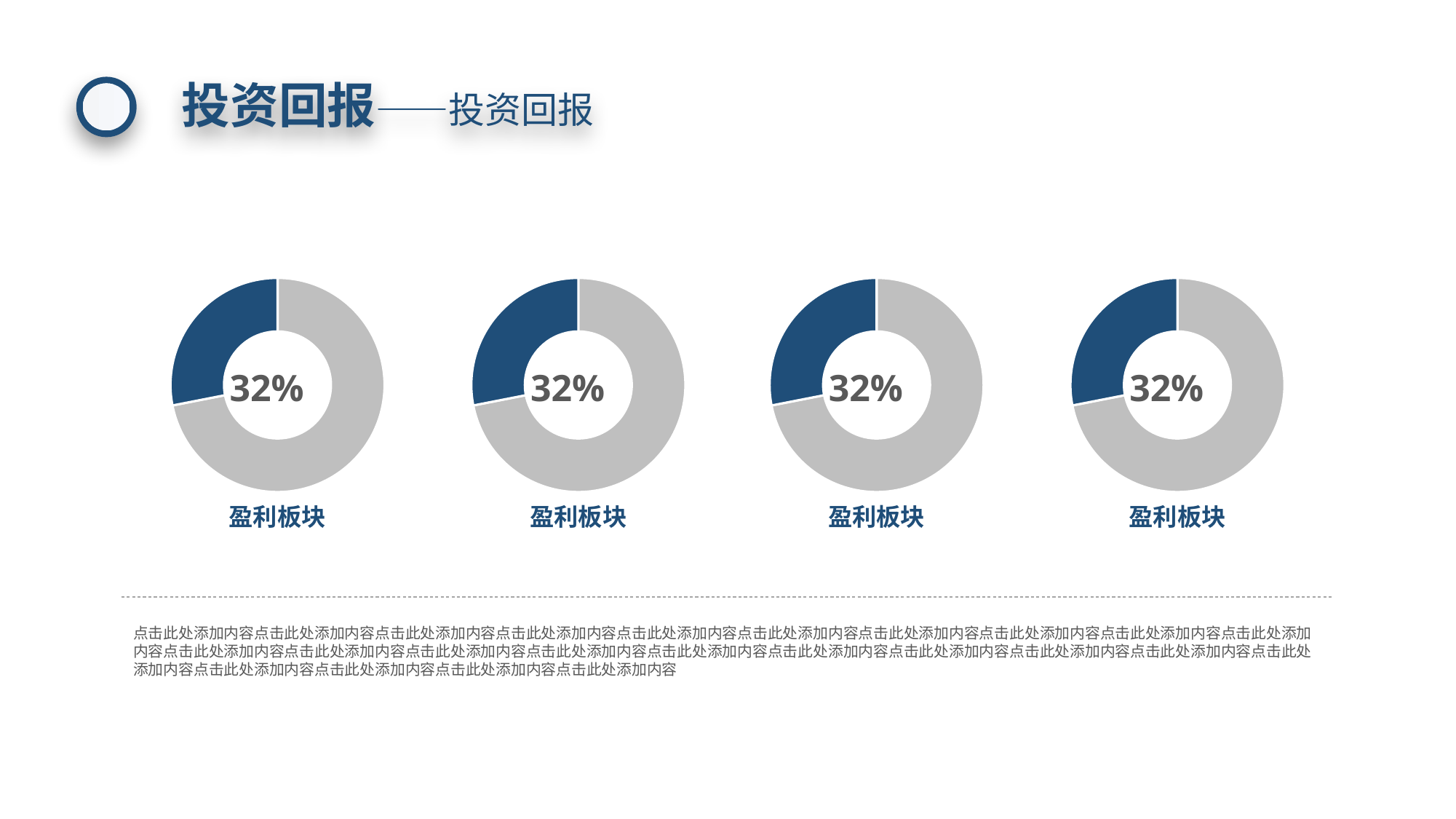
What label appears beneath each of the four donut charts? 盈利板块 In the leftmost donut chart, which colour represents the 32% portion? Blue What percentage is printed in the centre of the rightmost donut chart? 32% What percentage is printed in the centre of the leftmost donut chart? 32% What percentage is printed in the centre of the second donut chart from the left? 32% Is the value shown in the rightmost donut chart greater or less than 50%? less Do the four donut charts all show the same percentage value? Yes How many donut charts are shown on the slide? 4 In the leftmost donut chart, is the blue portion larger or smaller than the grey portion? Smaller What kind of chart is the leftmost chart on the slide? Donut chart